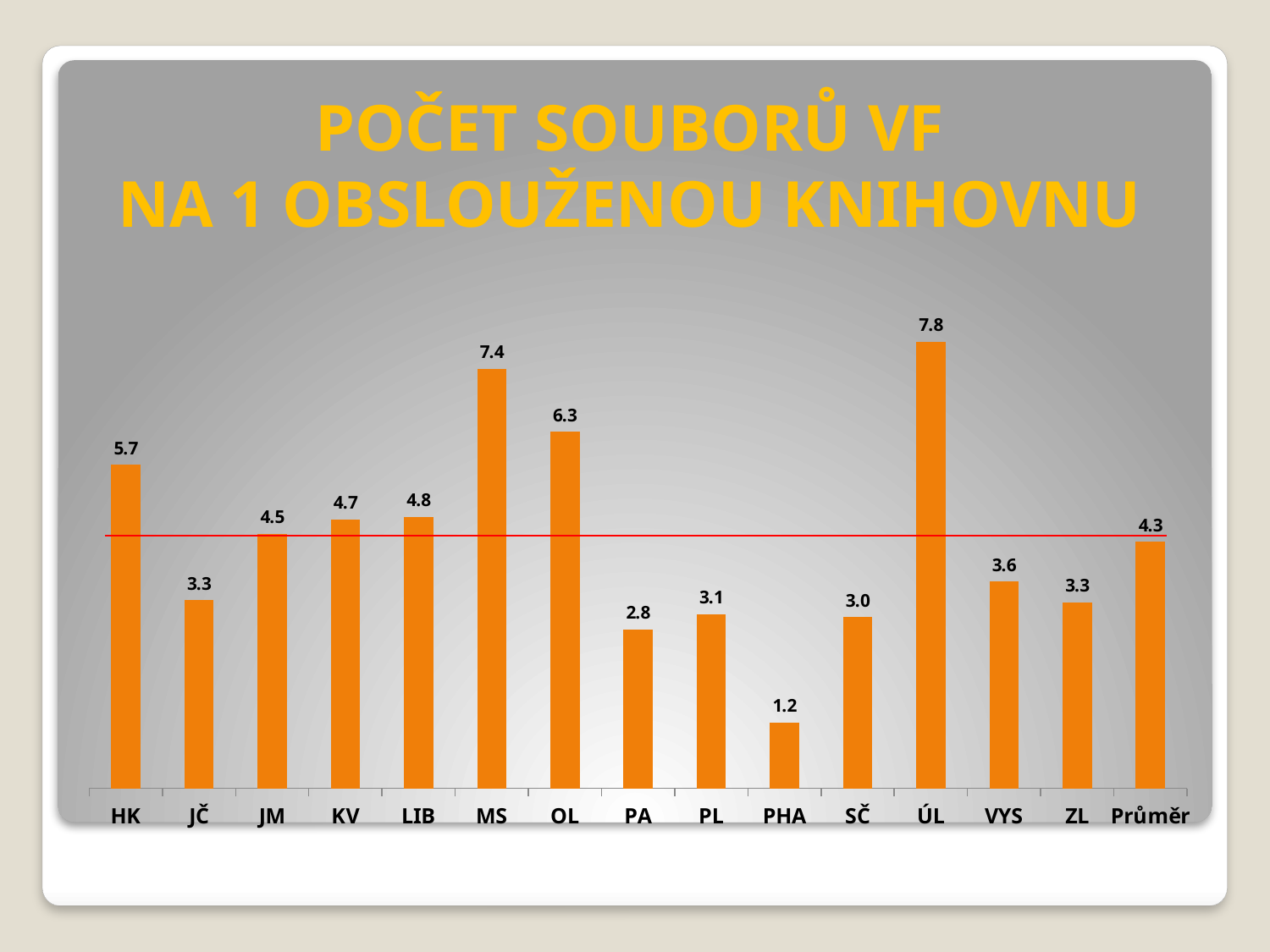
What kind of chart is shown on the slide? bar chart Which category has the lowest value? PHA What is the difference between the values for HK and JČ? 2.4 What is the value for MS? 7.4 Which category has the highest value? ÚL What is the title of the chart? POČET SOUBORŮ VF NA 1 OBSLOUŽENOU KNIHOVNU Which is larger, the value for OL or the value for KV? OL What is the value for Průměr? 4.3 What is the difference between the values for ÚL and MS? 0.4 How many categories are shown on the x axis? 15 What colour are the bars in the chart? orange What is the value for PHA? 1.2